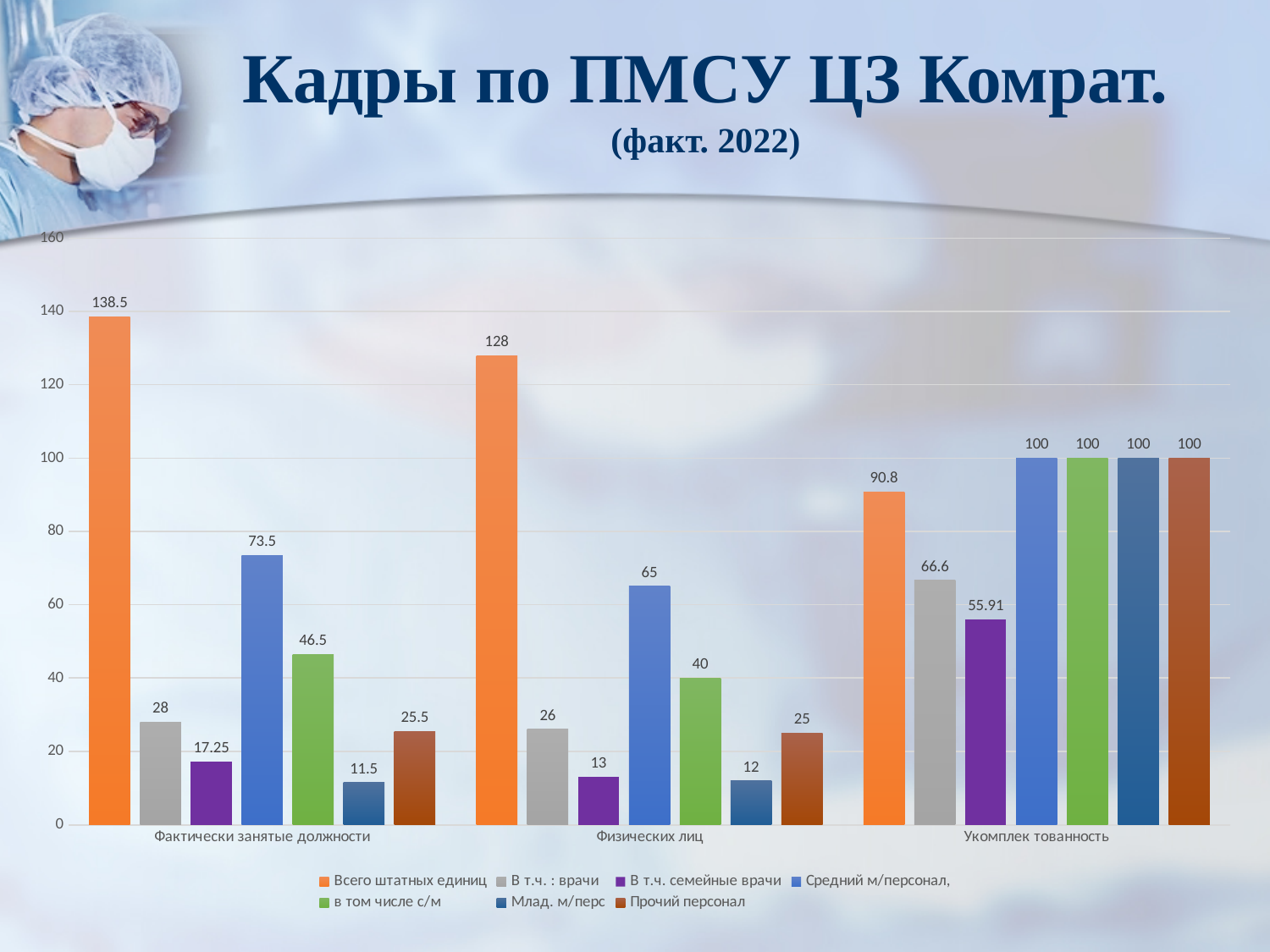
What is the value of "Млад. м/перс" for "Фактически занятые должности"? 11.5 What is the value of "Средний м/персонал" for "Физических лиц"? 65 How many series does the legend list? 7 What kind of chart is shown on the slide? Bar chart Which series has the highest value in the "Физических лиц" category? Всего штатных единиц How many categories are shown on the x axis? 3 Which series has the lowest value in the "Фактически занятые должности" category? Млад. м/перс What is the value of "Всего штатных единиц" for "Фактически занятые должности"? 138.5 What is the value of "В т.ч. семейные врачи" for "Укомплек тованность"? 55.91 How many series reach a value of 100 in the "Укомплек тованность" category? 4 Which is larger: "В т.ч. : врачи" for "Фактически занятые должности" or for "Физических лиц"? Фактически занятые должности What is the difference between "Всего штатных единиц" for "Фактически занятые должности" and for "Физических лиц"? 10.5